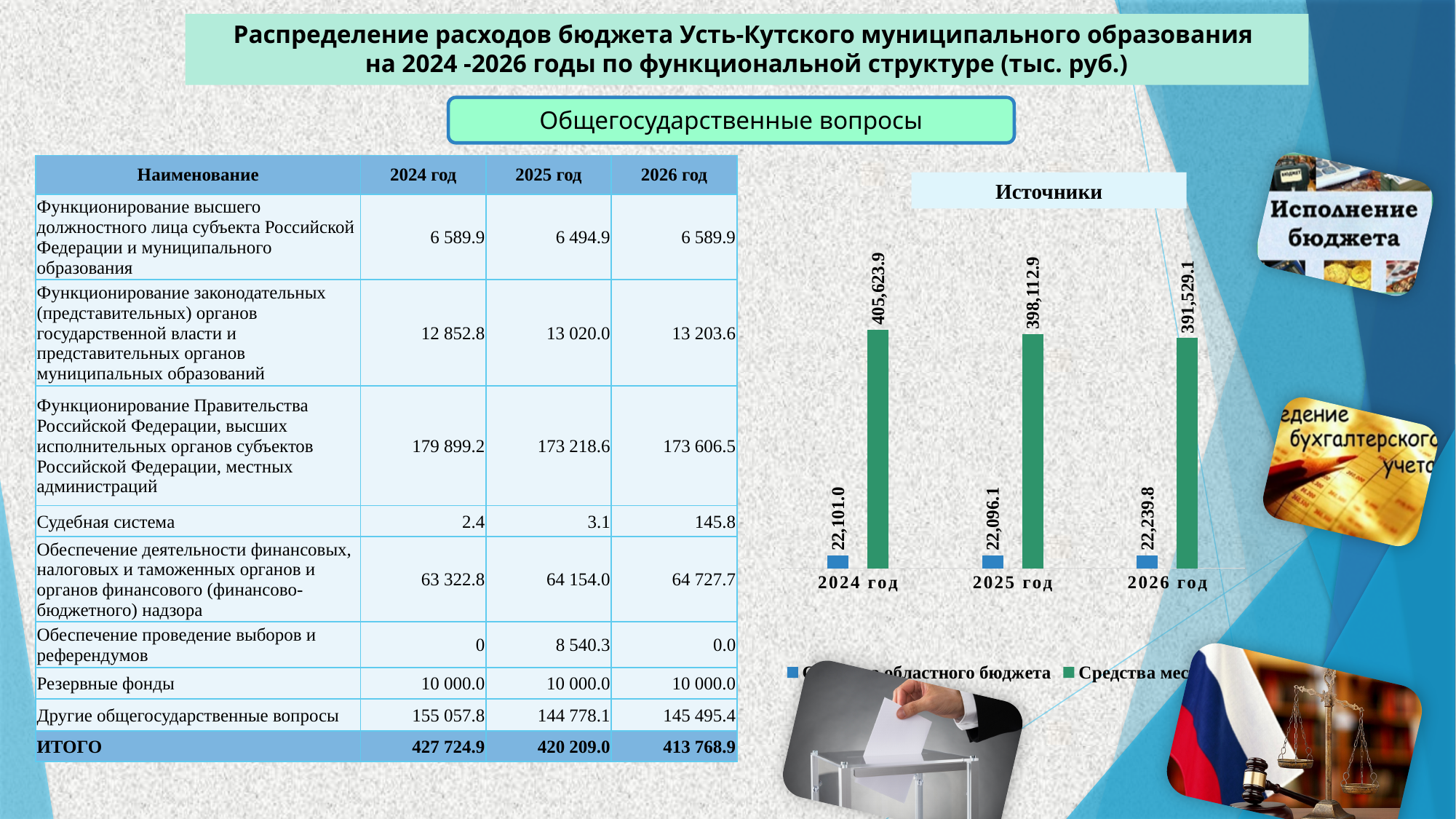
In the chart titled «Источники», what is the difference between the green bar values for 2024 год and 2026 год? 14,094.8 In the chart titled «Источники», how many series does the legend list? 2 In the chart titled «Источники», which year has the highest green bar? 2024 год In the chart titled «Источники», which year has the lowest green bar? 2026 год In the chart titled «Источники», what is the value of the blue bar for 2025 год? 22,096.1 In the chart titled «Источники», what is the value of the green bar for 2024 год? 405,623.9 What type of chart is the chart titled «Источники»? bar chart In the chart titled «Источники», how many years are shown on the x axis? 3 In the chart titled «Источники», what is the value of the green bar for 2026 год? 391,529.1 In the chart titled «Источники», what is the value of the blue bar for 2026 год? 22,239.8 In the chart titled «Источники», is the blue bar for 2024 год larger or smaller than the blue bar for 2025 год? larger In the chart titled «Источники», which year has the highest blue bar? 2026 год